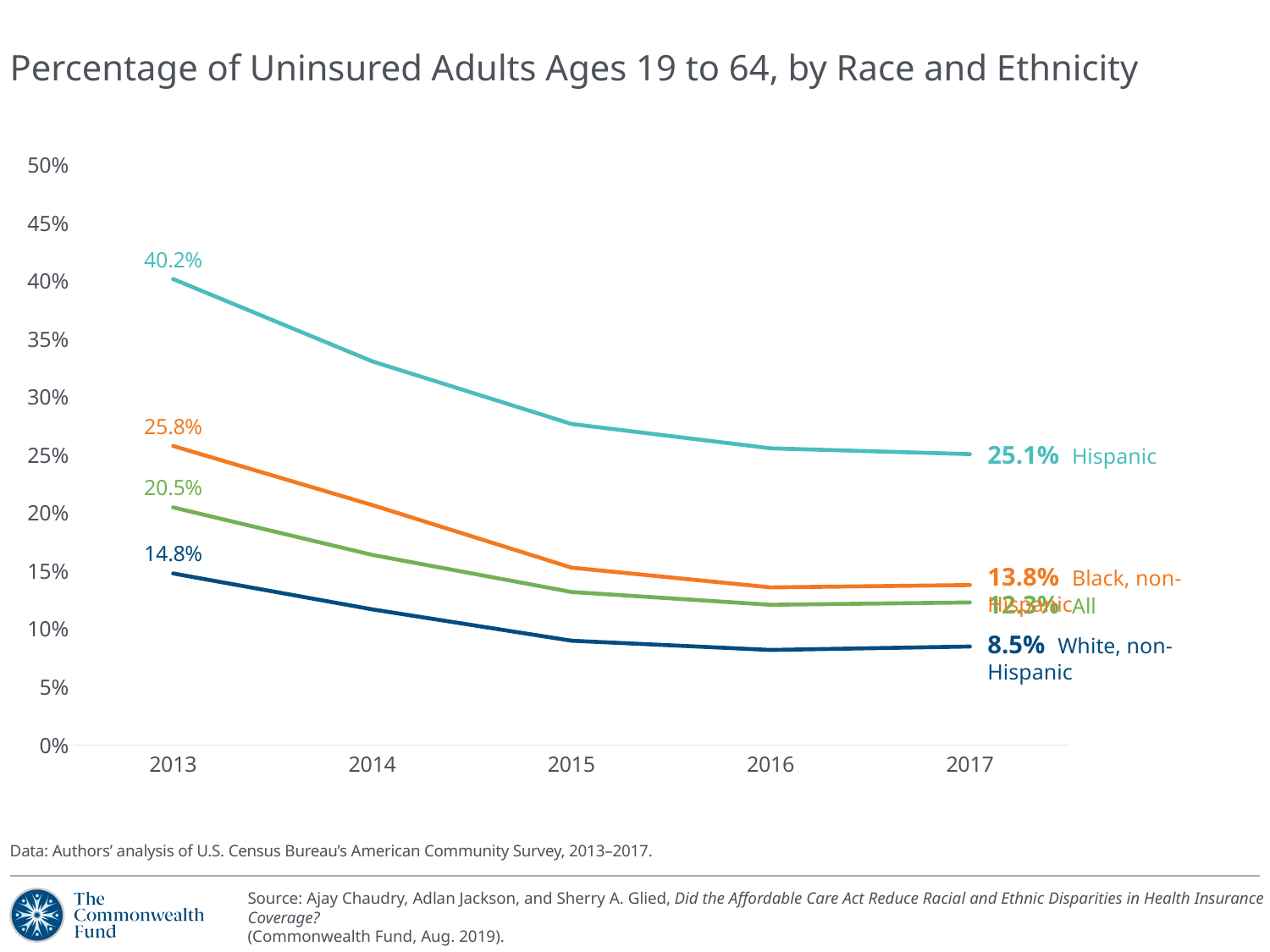
What kind of chart is shown on the slide? Line chart By how many percentage points did the Hispanic uninsured rate fall from 2013 to 2017? 15.1 percentage points What was the percentage of uninsured Hispanic adults in 2013? 40.2% What was the percentage of uninsured Black, non-Hispanic adults in 2013? 25.8% How many years are shown on the x axis? 5 What was the percentage of uninsured Hispanic adults in 2017? 25.1% What was the percentage of uninsured Black, non-Hispanic adults in 2017? 13.8% Is the Hispanic uninsured rate in 2015 greater or less than 30%? less What was the uninsured percentage for All adults in 2013? 20.5% Does the uninsured rate for White, non-Hispanic adults rise or fall from 2013 to 2017? Fall Which group had the highest uninsured percentage in 2013? Hispanic What was the percentage of uninsured White, non-Hispanic adults in 2017? 8.5%